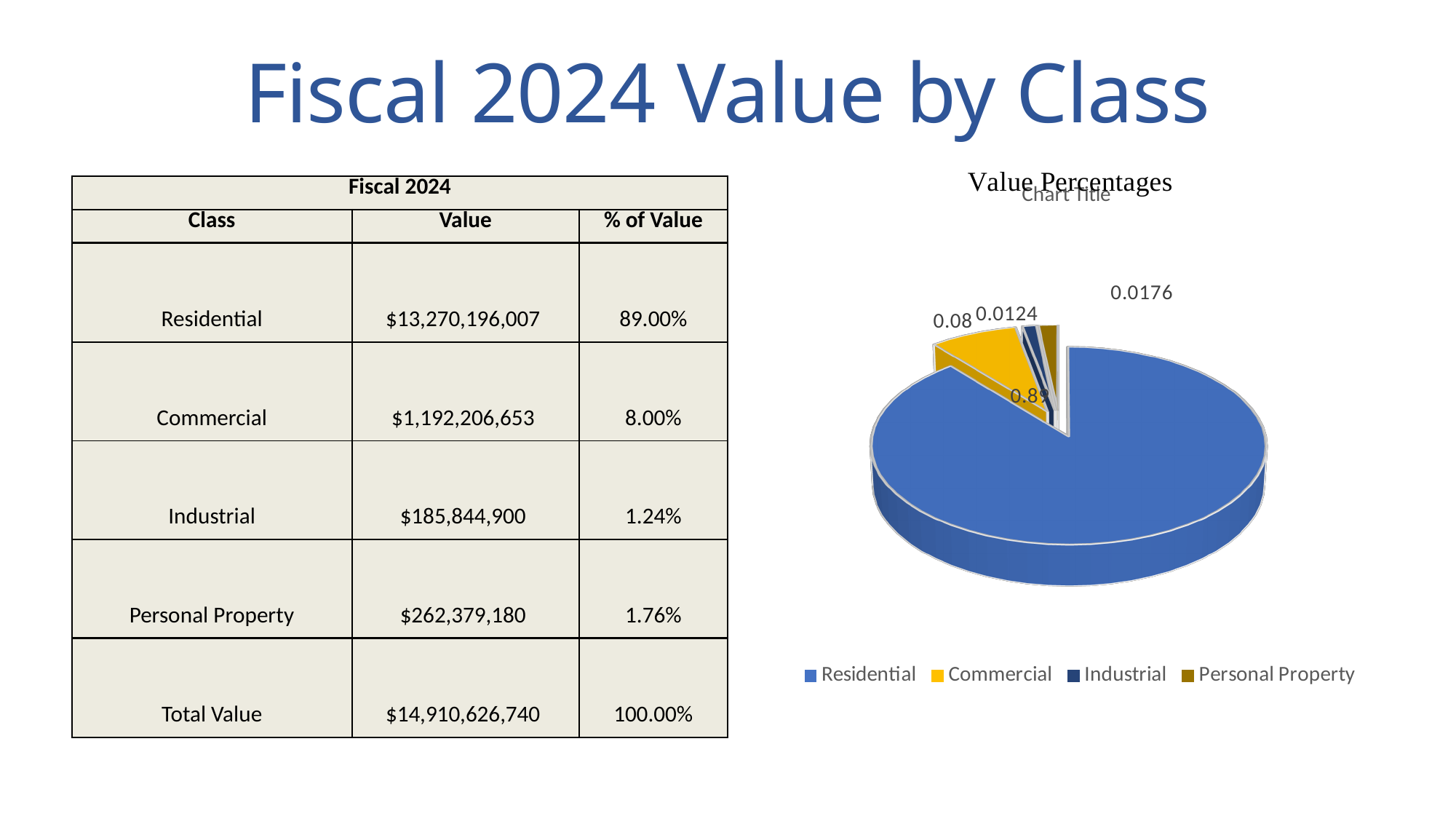
What value is labelled on the Commercial slice of the pie chart? 0.08 What kind of chart is shown on the slide? pie chart Which class has the largest slice in the pie chart? Residential What value is labelled on the Personal Property slice of the pie chart? 0.0176 What is the title printed above the pie chart? Value Percentages What value is labelled on the Industrial slice of the pie chart? 0.0124 Which legend entry in the pie chart is shown in yellow? Commercial How many slices does the pie chart have? 4 How many entries does the pie chart's legend list? 4 In the pie chart, which slice is larger, Commercial or Personal Property? Commercial Which class has the smallest slice in the pie chart? Industrial What is the difference between the labelled values of the Personal Property and Industrial slices in the pie chart? 0.0052